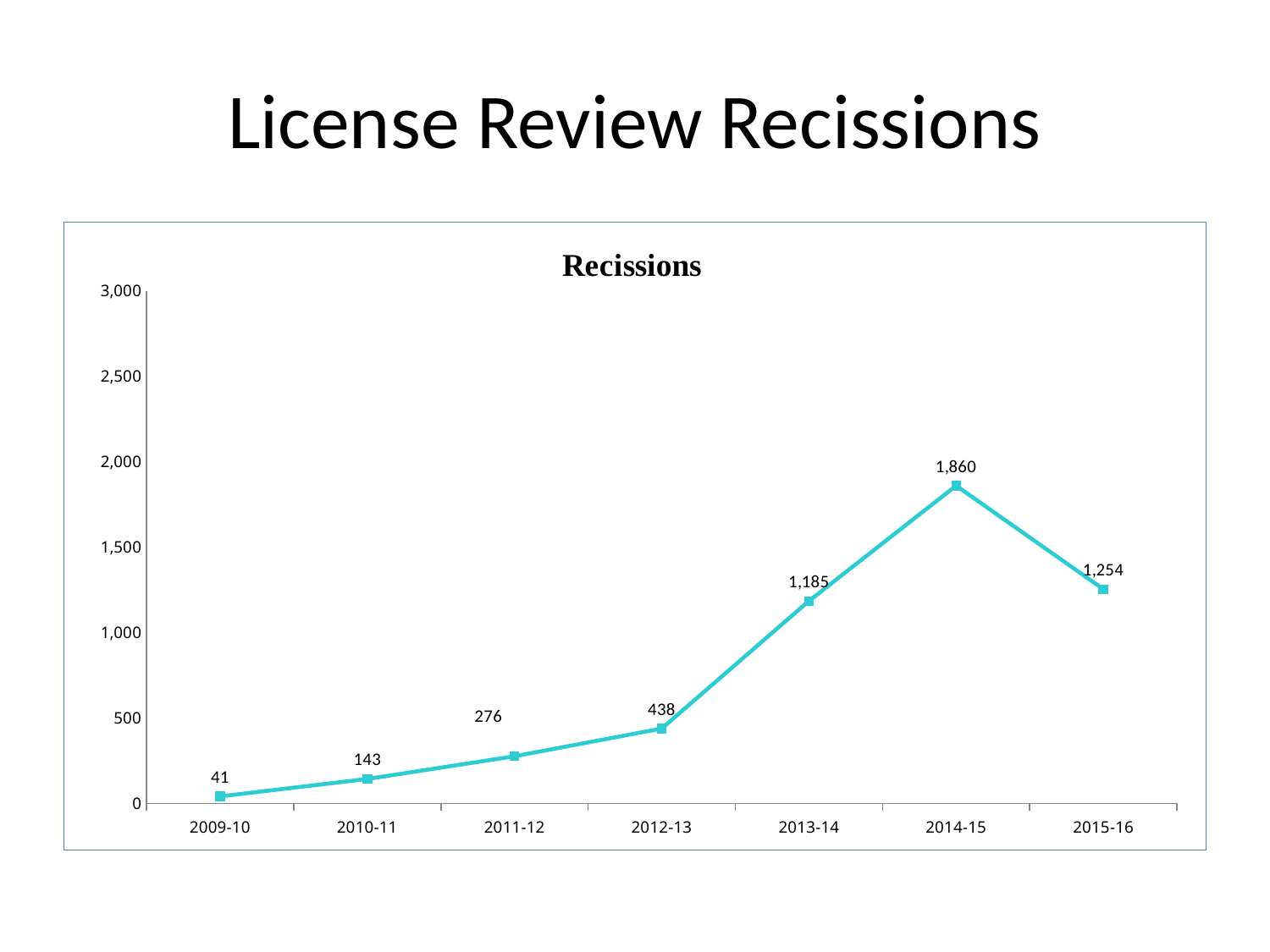
What is the title of the chart? Recissions What is the difference between the values for 2014-15 and 2015-16? 606 What is the value for 2009-10? 41 What kind of chart is shown? line chart Is the value for 2011-12 greater or less than 500? less Which is larger, the value for 2015-16 or the value for 2013-14? 2015-16 What is the value for 2012-13? 438 Which year has the highest value? 2014-15 How many years are plotted on the chart? 7 What is the difference between the values for 2013-14 and 2012-13? 747 What is the value for 2014-15? 1,860 Which year has the lowest value? 2009-10